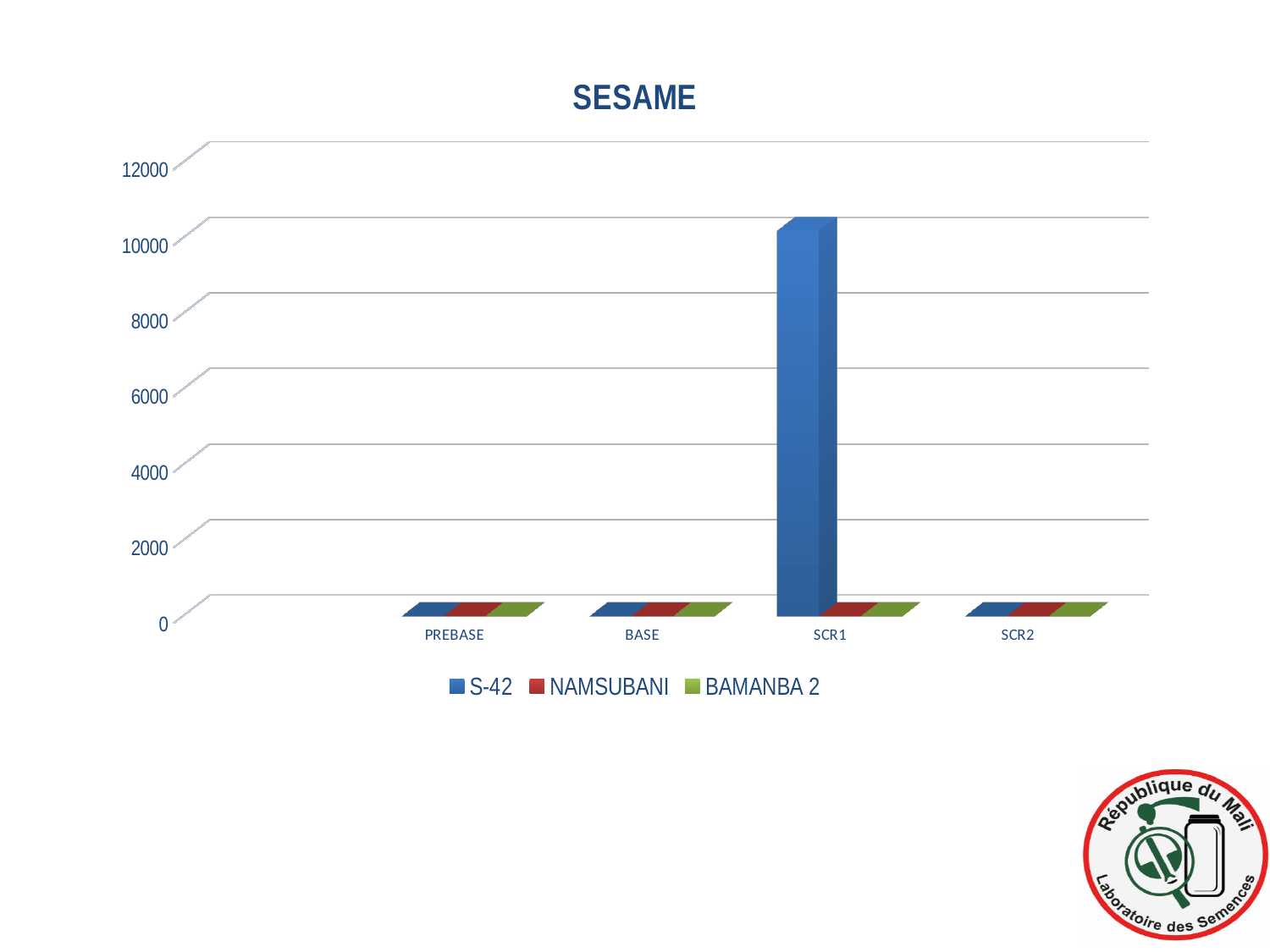
Which series is shown in green in the legend? BAMANBA 2 Is the value for NAMSUBANI at SCR1 greater or less than 2000? less What kind of chart is shown on the slide? bar chart Is the value for S-42 at SCR1 greater or less than 12000? less How many series does the legend list? 3 Is the value for S-42 at SCR1 greater or less than 8000? greater Which is larger: the value for S-42 at SCR1 or the value for S-42 at SCR2? SCR1 How many categories are shown on the x axis? 4 Which is larger at SCR1: the value for S-42 or the value for BAMANBA 2? S-42 Which category has the highest value for S-42? SCR1 What is the title of the chart? SESAME